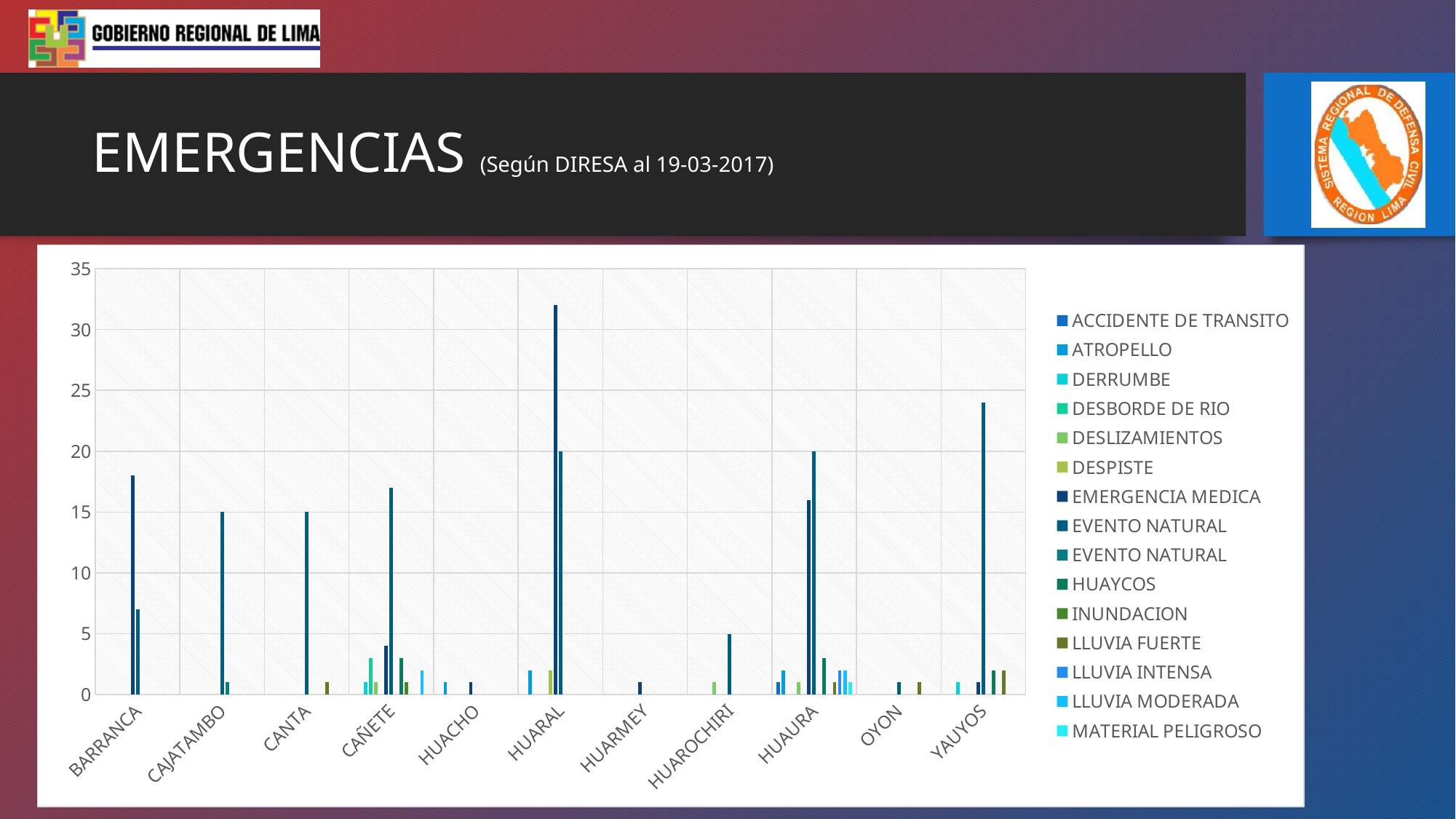
Is the tallest bar for YAUYOS greater or less than 20? greater Which category has the taller tallest bar, HUARAL or YAUYOS? HUARAL Which category has the tallest bar in the chart? HUARAL Which category has the taller tallest bar, BARRANCA or CAJATAMBO? BARRANCA Is the tallest bar for HUACHO greater or less than 5? less Is the tallest bar for HUARMEY greater or less than 5? less How many series does the chart's legend list? 15 What kind of chart is shown on the slide? bar chart How many categories (provinces) are shown along the x axis of the chart? 11 What is the title of the slide containing the chart? EMERGENCIAS (Según DIRESA al 19-03-2017)